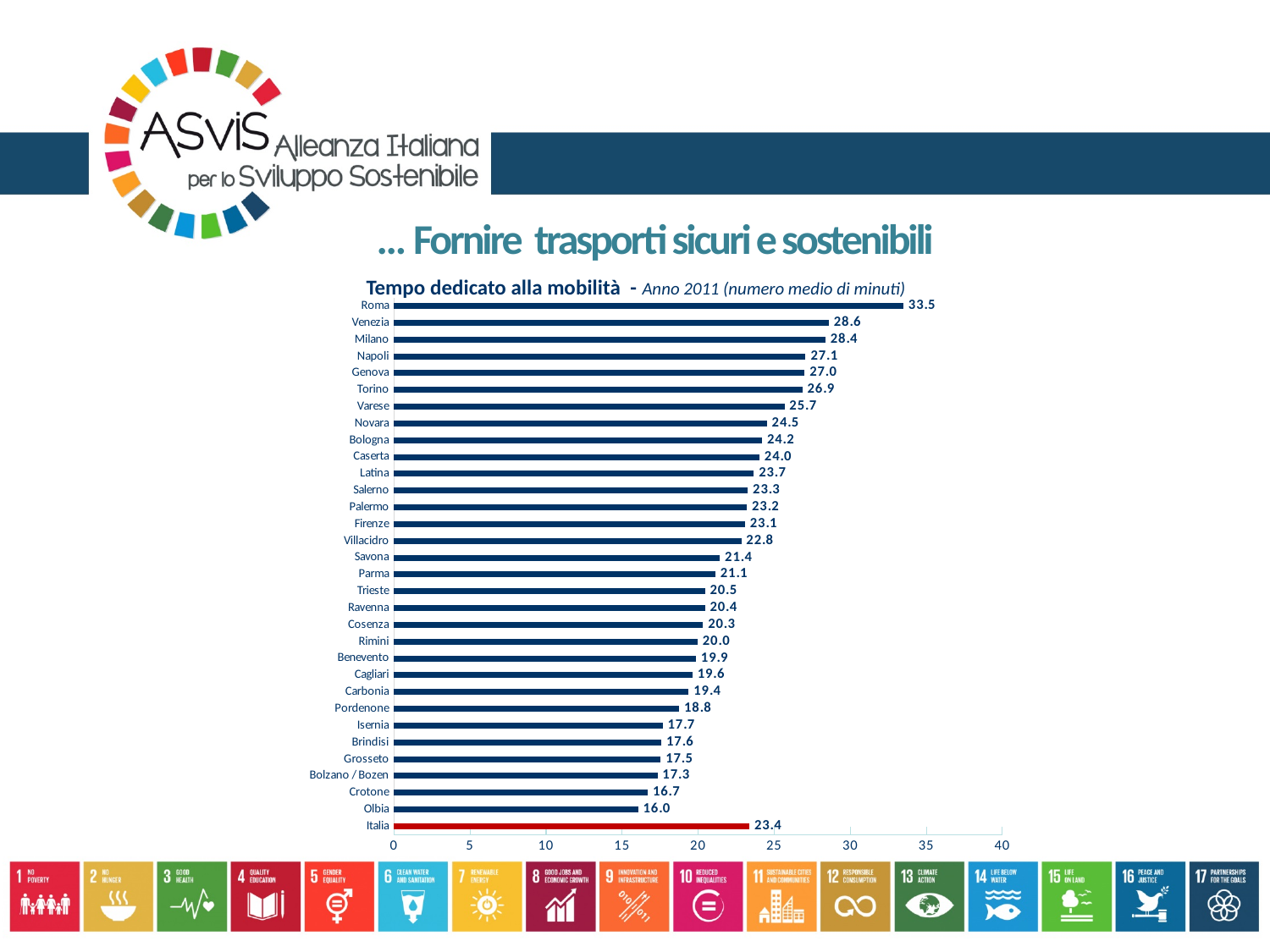
What is the value for Italia? 23.4 What is the value for Roma? 33.5 Is the value for Napoli greater or less than 25? greater Which category has the lowest value? Olbia How many categories are plotted in the chart? 32 Which has a larger value, Venezia or Milano? Venezia What is the value for Olbia? 16.0 What is the title of the chart? Tempo dedicato alla mobilità - Anno 2011 (numero medio di minuti) What is the difference between the values for Roma and Italia? 10.1 Which bar is shown in a different colour (red) from the others? Italia Which category has the highest value? Roma What kind of chart is shown on the slide? bar chart